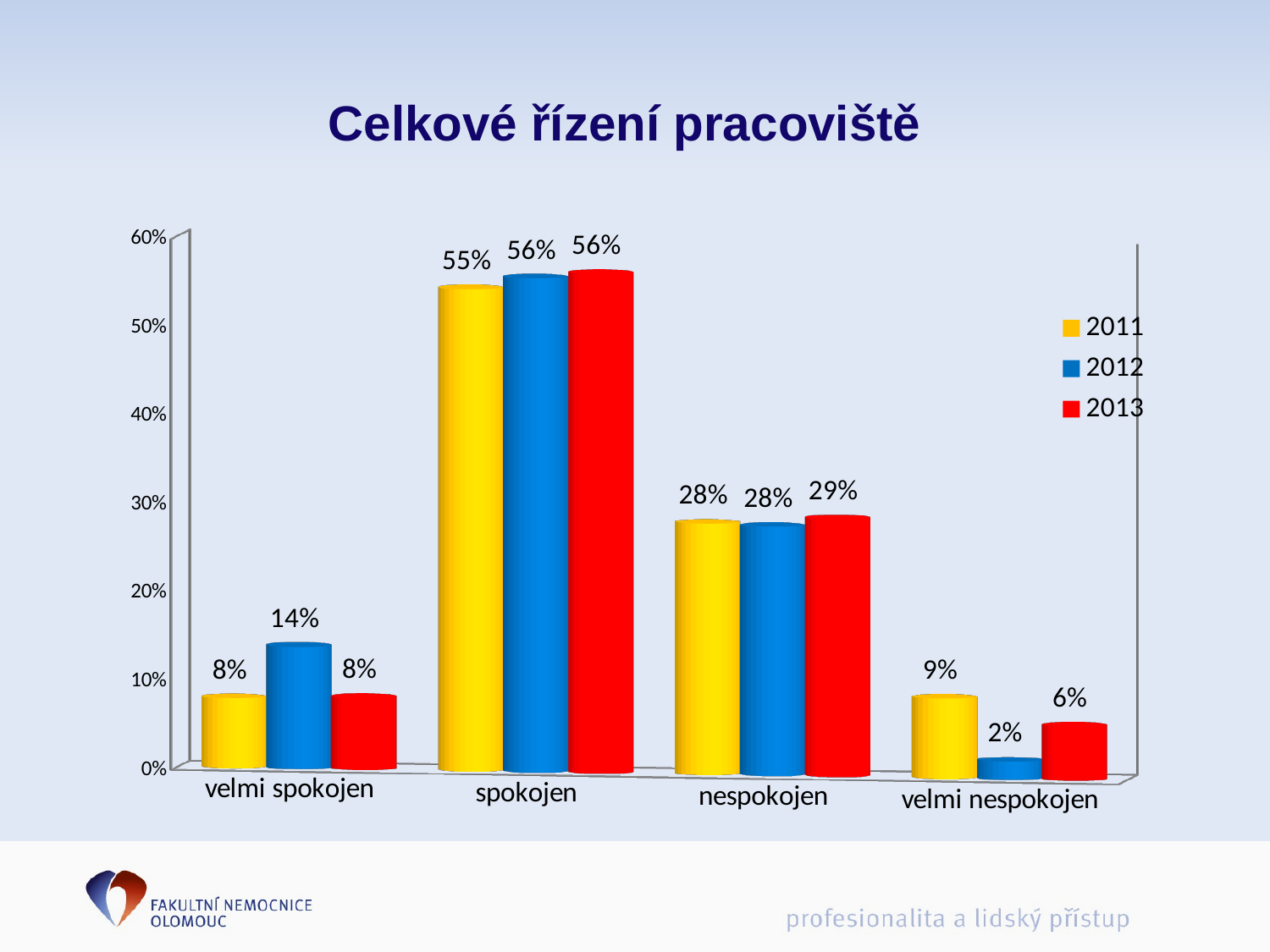
How many series does the legend list? 3 Which category has the highest value for the 2013 series? spokojen What is the difference between the 2012 and 2011 values in the 'velmi spokojen' category? 6% What is the value for 2013 in the 'nespokojen' category? 29% What is the title of the chart? Celkové řízení pracoviště What is the value for 2012 in the 'velmi spokojen' category? 14% What kind of chart is shown on the slide? bar chart How many categories are shown on the x axis? 4 What is the value for 2011 in the 'velmi nespokojen' category? 9% Which category has the lowest value for the 2012 series? velmi nespokojen Is the 2011 value for 'spokojen' greater or less than 50%? greater Which is larger in the 'velmi nespokojen' category: the 2011 value or the 2013 value? 2011